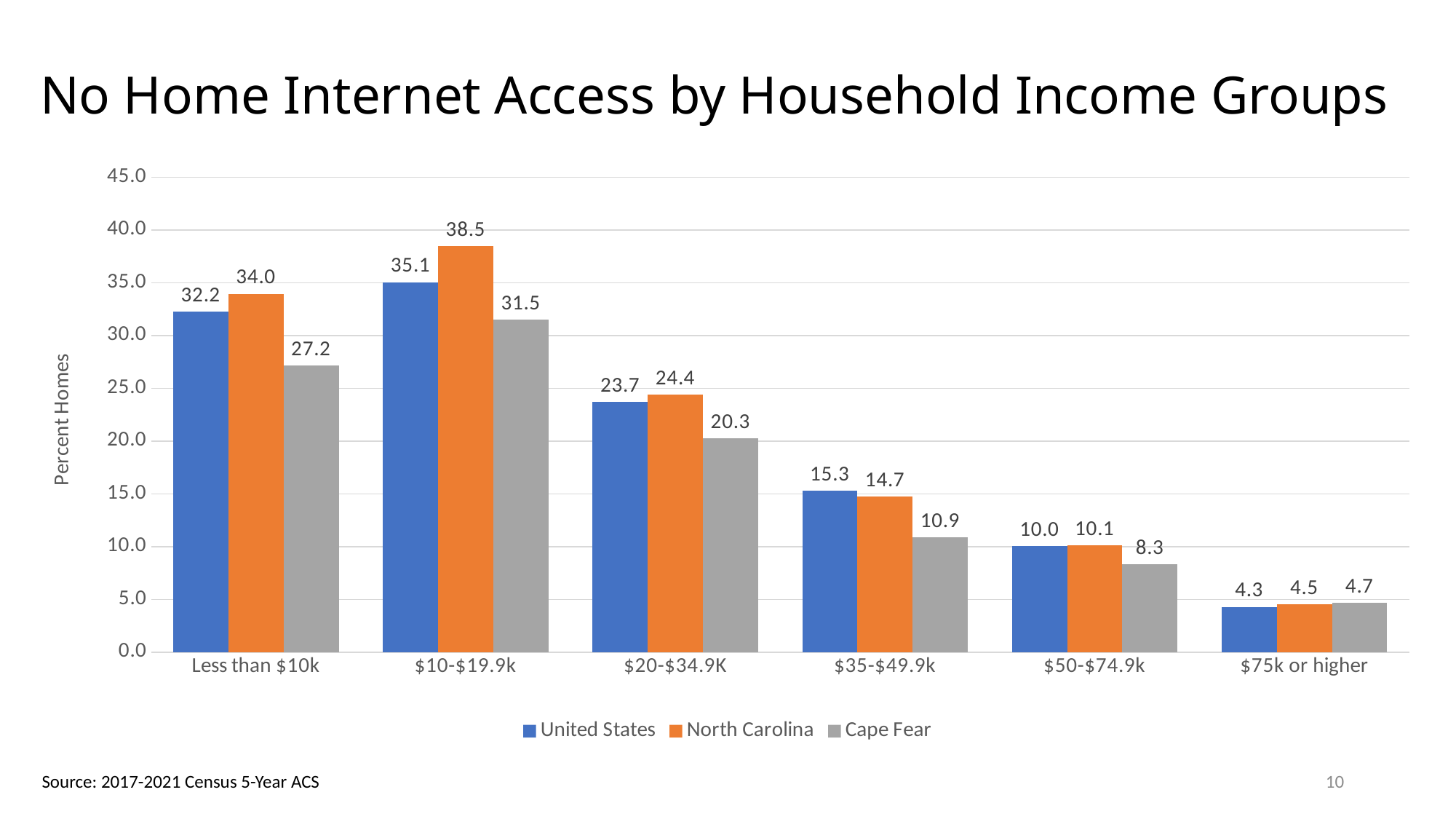
What kind of chart is shown on the slide? Bar chart Do the United States values rise or fall as household income increases along the x axis? Fall What is the difference between the North Carolina and Cape Fear values in the Less than $10k group? 6.8 Which income group has the highest value for North Carolina? $10-$19.9k In the $35-$49.9k group, which is larger: the United States value or the North Carolina value? United States Is the value for Cape Fear in the $10-$19.9k group greater or less than 30.0? greater What is the value for United States in the $50-$74.9k income group? 10.0 Which income group has the lowest value for Cape Fear? $75k or higher How many income groups are shown on the x axis? 6 What is the value for Cape Fear in the $20-$34.9K income group? 20.3 How many series does the legend list? 3 What is the value for North Carolina in the $10-$19.9k income group? 38.5